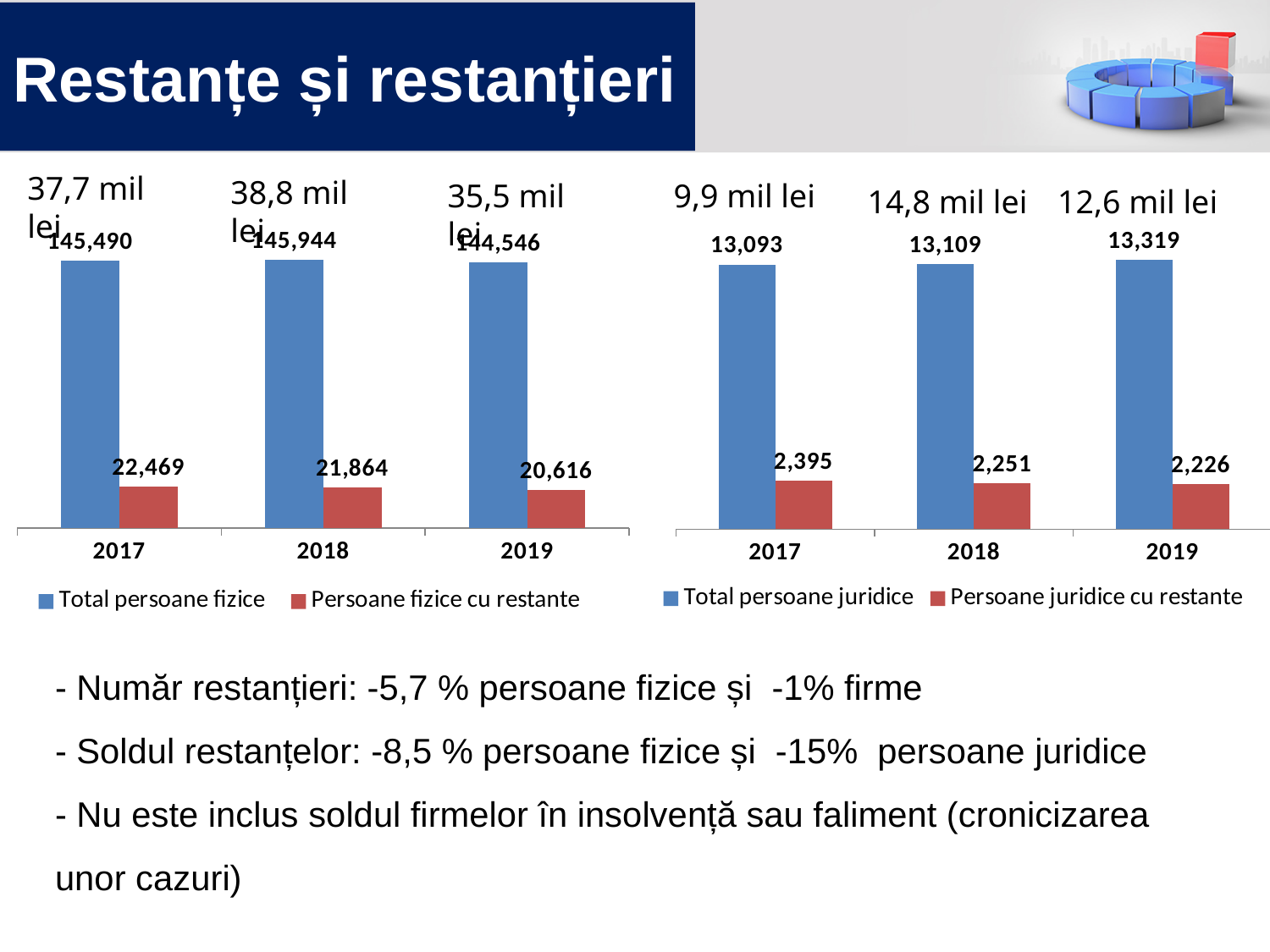
In the right chart, which year has the lowest value for Persoane juridice cu restante? 2019 In the right chart, what is the value of Total persoane juridice for 2019? 13,319 In the left chart, which year has the highest value for Persoane fizice cu restante? 2017 In the left chart, what is the value of Persoane fizice cu restante for 2019? 20,616 In the right chart, what is the value of Persoane juridice cu restante for 2017? 2,395 What type of chart is the left chart? bar chart In the left chart, what is the difference between Persoane fizice cu restante in 2017 and in 2019? 1,853 In the left chart, what is the value of Total persoane fizice for 2018? 145,944 In the right chart, what is the difference between Total persoane juridice in 2019 and in 2017? 226 How many series does the legend of the right chart list? 2 In the right chart, do the values for Persoane juridice cu restante rise or fall from 2017 to 2019? fall In the left chart, is Total persoane fizice larger in 2018 or in 2019? 2018